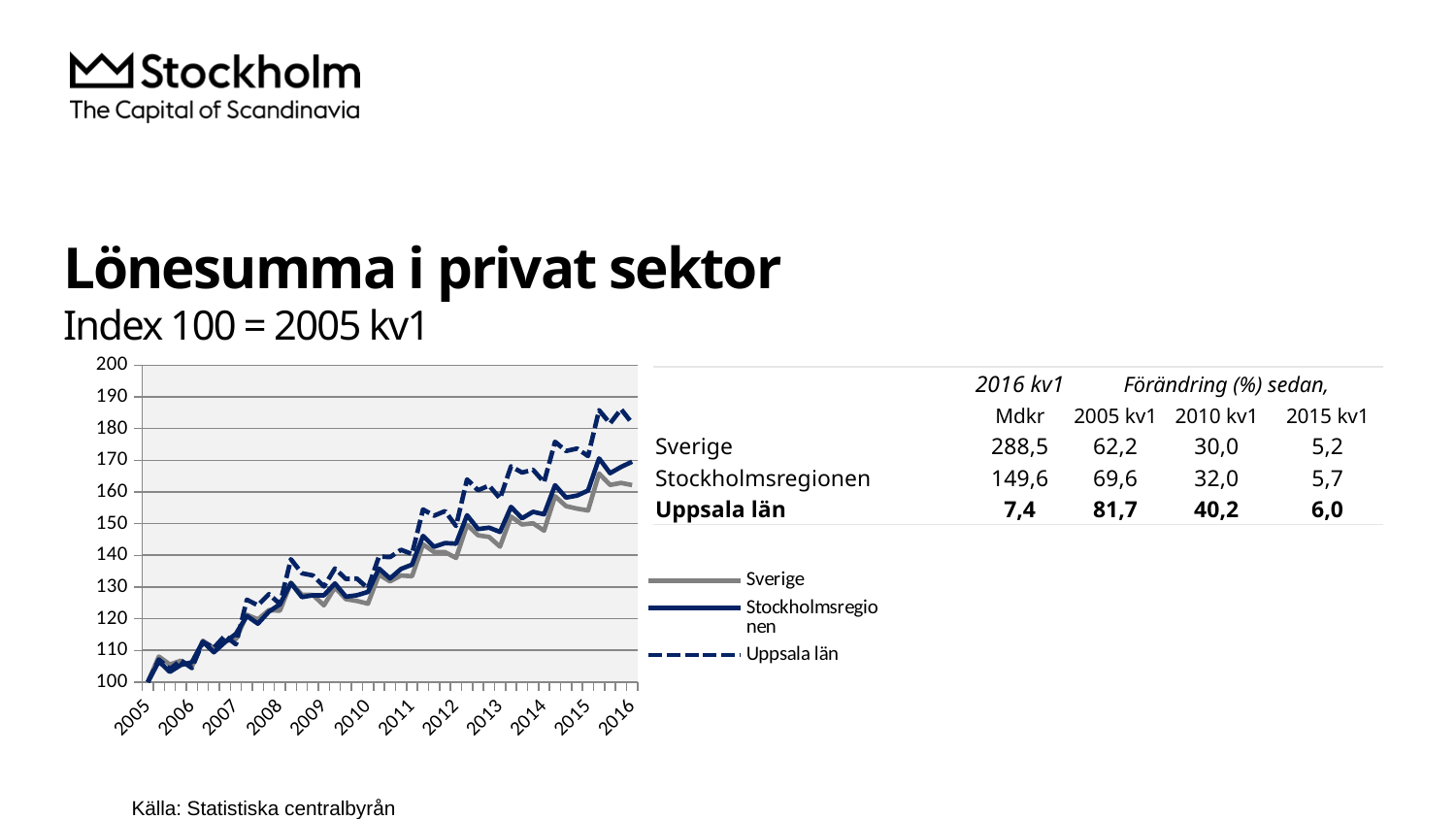
Which series has the lowest index value at the end of the chart in 2016? Sverige At the end of the chart in 2016, which is higher: Uppsala län or Sverige? Uppsala län What is the title of the chart on the slide? Lönesumma i privat sektor What kind of chart is shown on the slide? line chart What index value do all three series start at in 2005 kv1? 100 Is the index value for Sverige at the end of the chart in 2016 greater or less than 170? less How many series does the chart's legend list? 3 Is the index value for Stockholmsregionen at the end of the chart in 2016 greater or less than 160? greater Do the index values in the chart generally rise or fall from 2005 to 2016? rise Which series has the highest index value at the end of the chart in 2016? Uppsala län Which series is drawn with a dashed line in the chart? Uppsala län